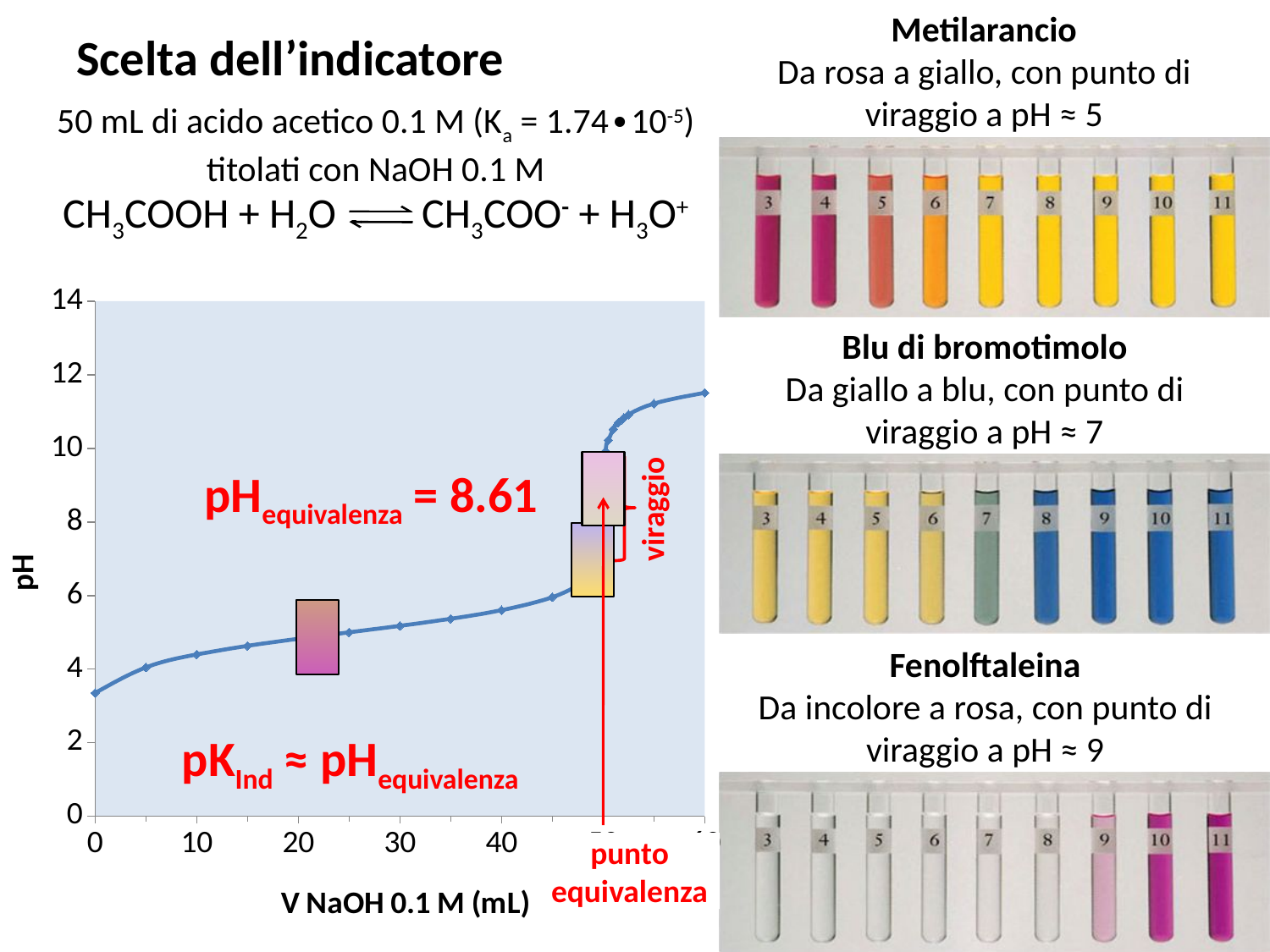
What is the label of the x axis of the titration chart? V NaOH 0.1 M (mL) What kind of chart is shown on the left of the slide? line chart According to the annotation on the chart, what is the pH at the equivalence point? 8.61 Is the pH at 40 mL of NaOH greater or less than 6? less What is the maximum value shown on the pH axis of the chart? 14 Does the pH rise or fall as the volume of NaOH increases along the x axis? rise Is the pH at 0 mL of NaOH greater or less than 4? less Is the pH at 10 mL of NaOH greater or less than 6? less Which is larger, the pH at 10 mL of NaOH or the pH at 40 mL of NaOH? 40 mL What is the label of the y axis of the titration chart? pH